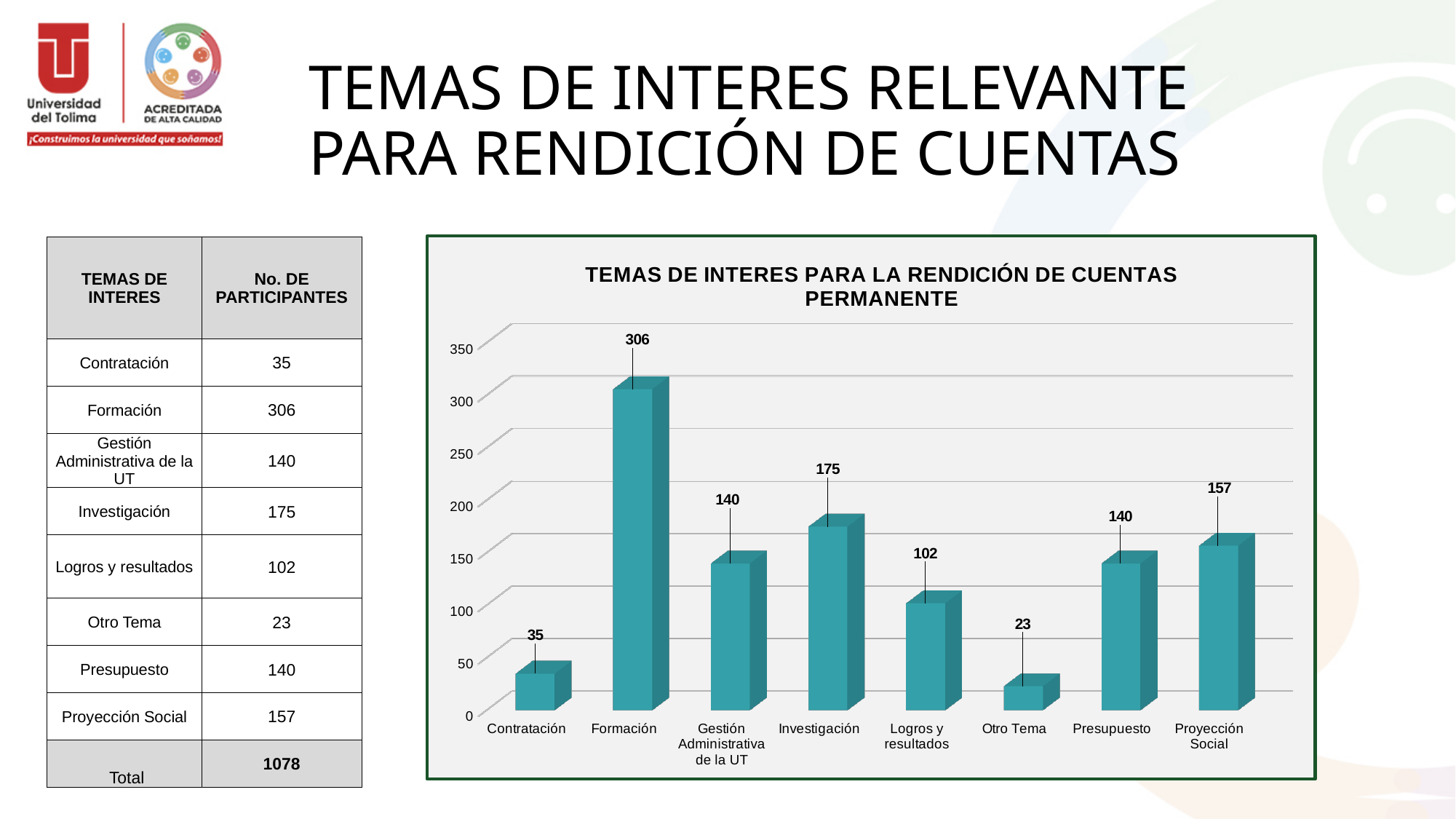
What kind of chart is shown? bar chart What is the difference between the values for Presupuesto and Otro Tema? 117 Which is larger, the value for Investigación or the value for Proyección Social? Investigación What is the value for Proyección Social? 157 How many categories are shown on the x axis? 8 Which category has the lowest value? Otro Tema What is the difference between the values for Formación and Investigación? 131 Is the value for Contratación greater or less than 50? less What is the value for Logros y resultados? 102 What is the title of the chart? TEMAS DE INTERES PARA LA RENDICIÓN DE CUENTAS PERMANENTE Which category has the highest value? Formación What is the value for Formación? 306